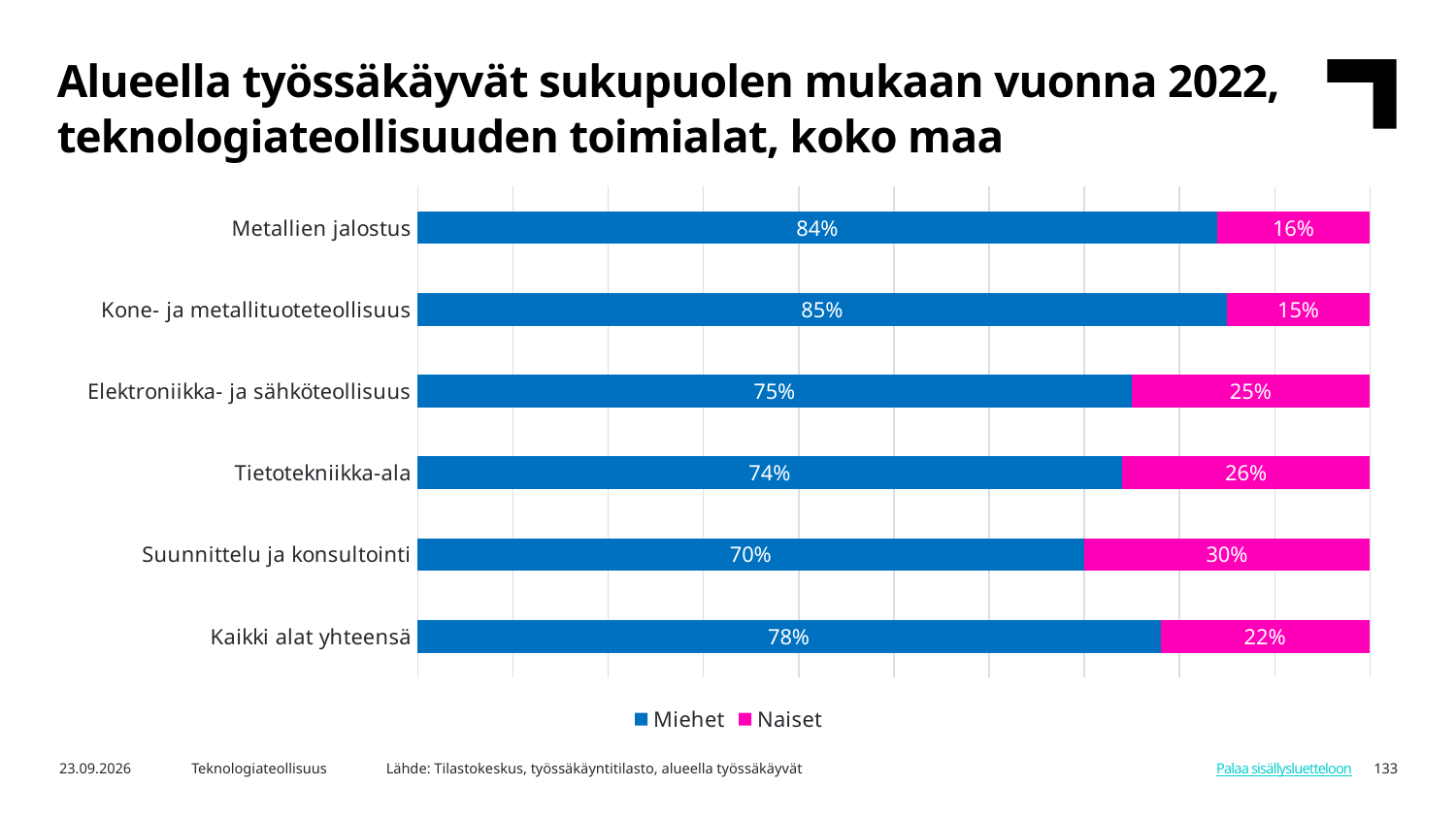
What is the Miehet share for Metallien jalostus? 84% Which is larger: the Naiset share for Elektroniikka- ja sähköteollisuus or for Tietotekniikka-ala? Tietotekniikka-ala What is the total of the stacked bar for Kone- ja metallituoteteollisuus? 100% Which category has the highest Miehet share? Kone- ja metallituoteteollisuus What is the Naiset share for Kaikki alat yhteensä? 22% How many categories are shown on the chart? 6 Which category has the lowest Miehet share? Suunnittelu ja konsultointi How many series does the legend list? 2 What is the difference between the Naiset share for Suunnittelu ja konsultointi and for Metallien jalostus? 14 percentage points What is the Miehet share for Tietotekniikka-ala? 74% What is the Naiset share for Suunnittelu ja konsultointi? 30% What kind of chart is shown on the slide? Stacked bar chart